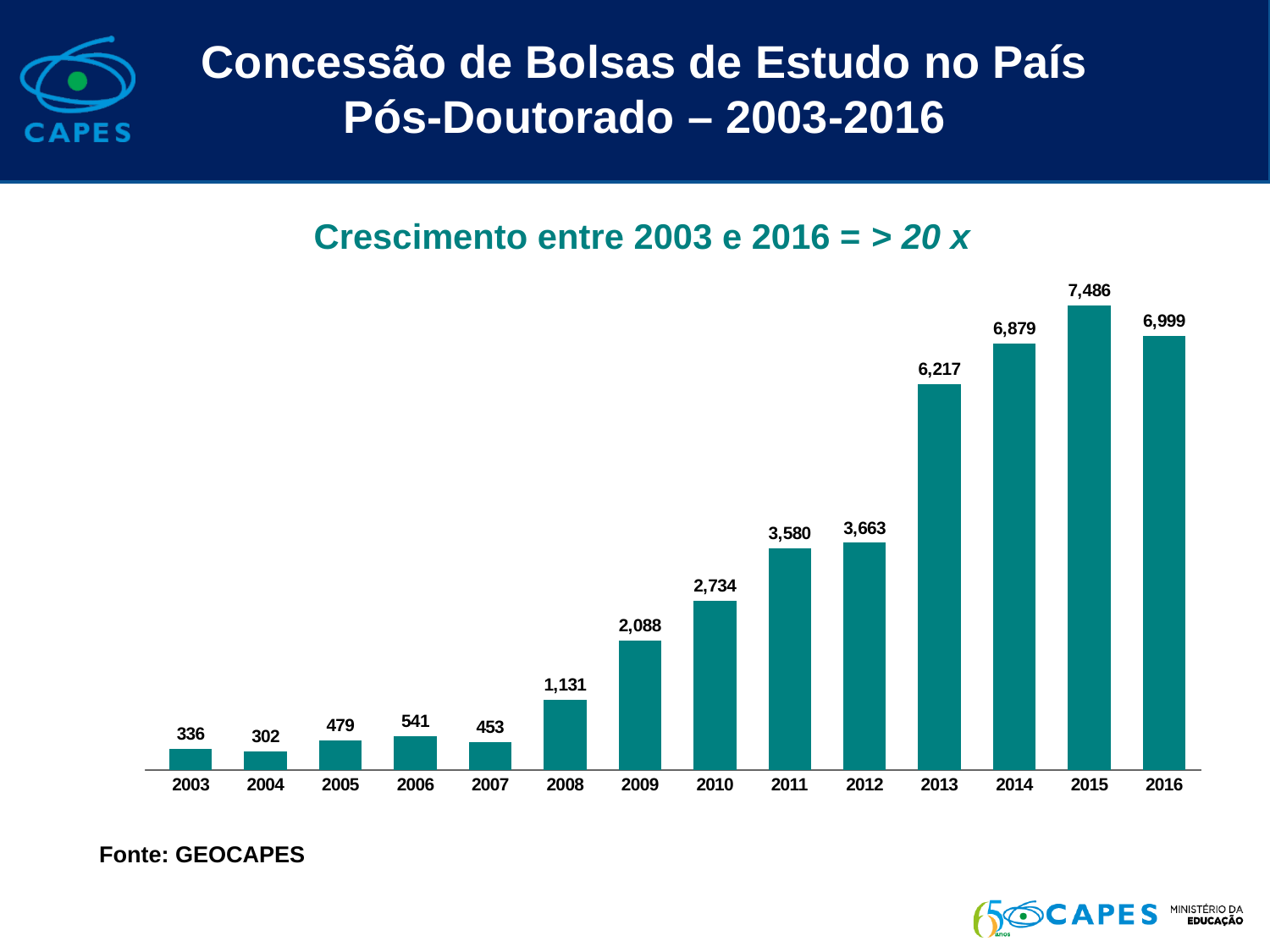
What kind of chart is this? bar chart What is the value for 2010? 2,734 What is the difference between the values for 2015 and 2016? 487 Which is larger, the value for 2006 or the value for 2007? 2006 What is the value for 2016? 6,999 What is the difference between the values for 2009 and 2008? 957 Which year has the highest value? 2015 How many years are shown on the x axis? 14 Do the values generally rise or fall from 2003 to 2015? rise What is the source cited below the chart? GEOCAPES What is the value for 2003? 336 Which year has the lowest value? 2004